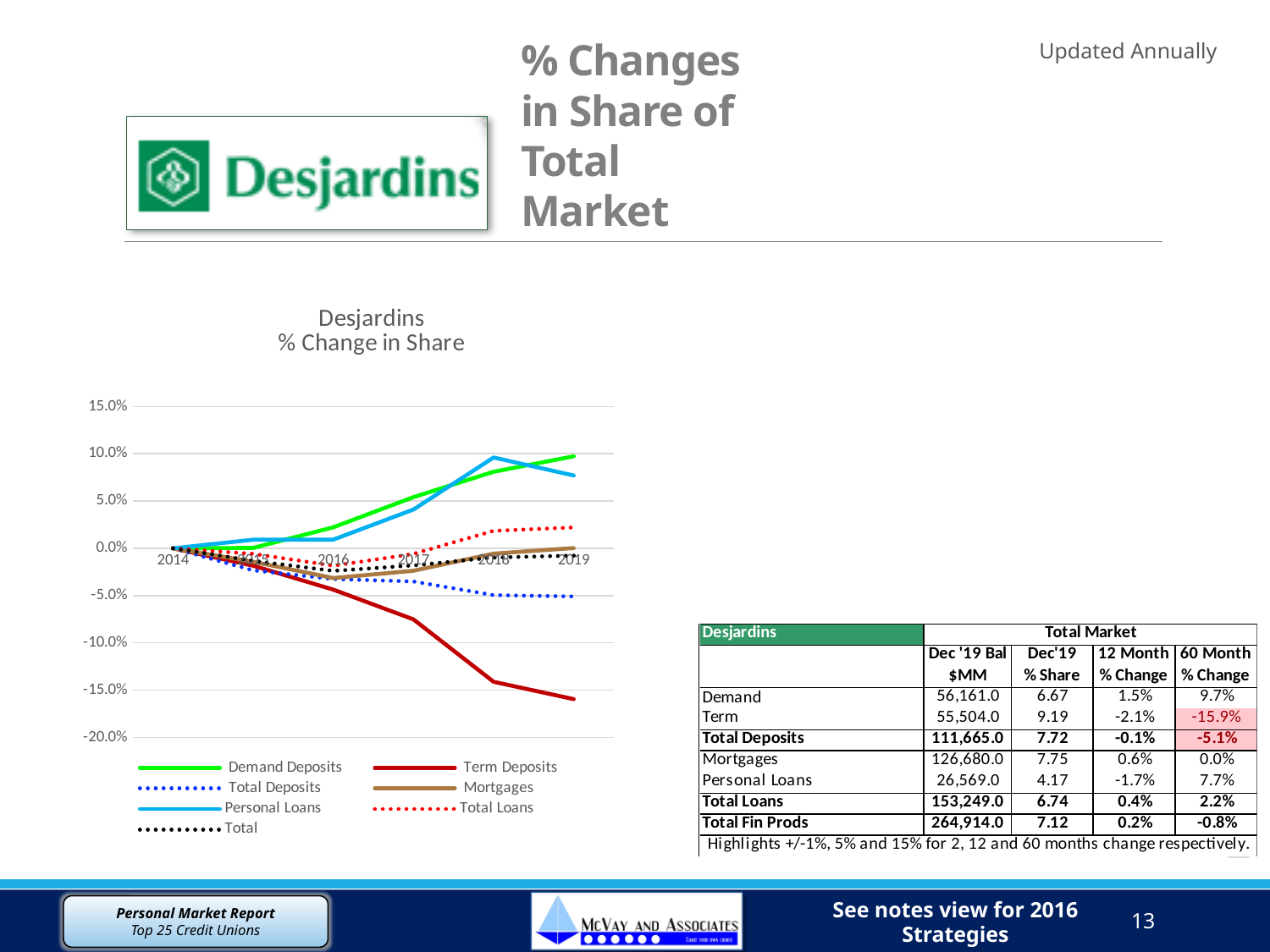
How many years are plotted along the x axis of the chart? 6 Which series has the lowest value in 2019? Term Deposits How many series does the chart legend list? 7 Does the Term Deposits line rise or fall from 2014 to 2019? fall What kind of chart is shown on the slide? line chart Is the value for Term Deposits in 2019 greater or less than -15.0%? less What is the title of the chart? Desjardins % Change in Share Is the value for Demand Deposits in 2019 greater or less than 5.0%? greater Is the value for Term Deposits in 2018 greater or less than -10.0%? less Which is larger in 2019, Demand Deposits or Term Deposits? Demand Deposits Does the Demand Deposits line rise or fall from 2014 to 2019? rise Which series has the highest value in 2019? Demand Deposits